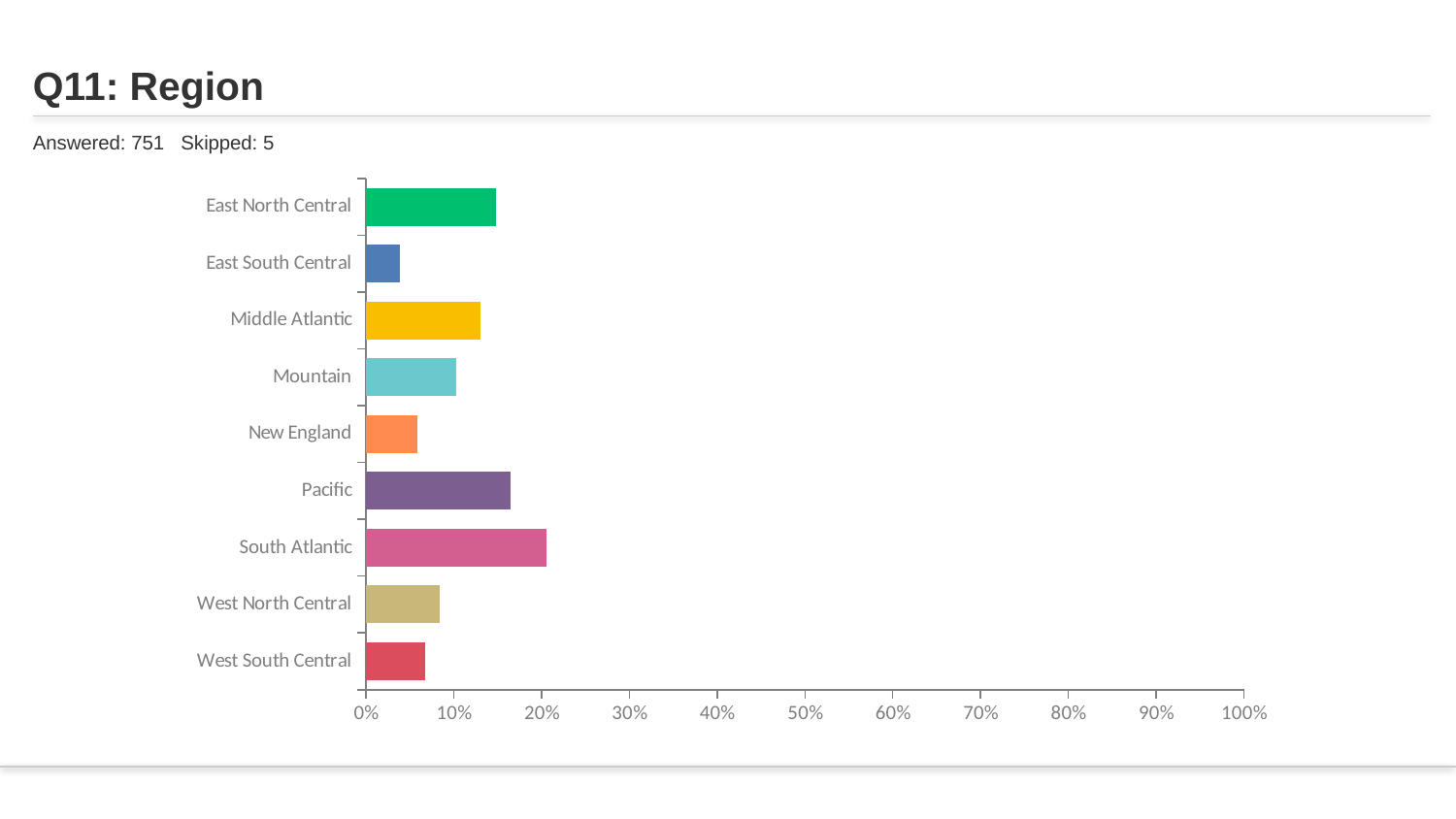
Is the value for East South Central greater or less than 10%? less Is the value for Pacific greater or less than 10%? greater How many regions are plotted in the chart? 9 What is the title of the chart? Q11: Region Which is larger, the value for Middle Atlantic or the value for New England? Middle Atlantic Which is larger, the value for South Atlantic or the value for Pacific? South Atlantic Which region has the lowest value? East South Central Which region has the highest value? South Atlantic What kind of chart is shown on the slide? bar chart Is the value for South Atlantic greater or less than 10%? greater How many respondents answered the question shown in the chart? 751